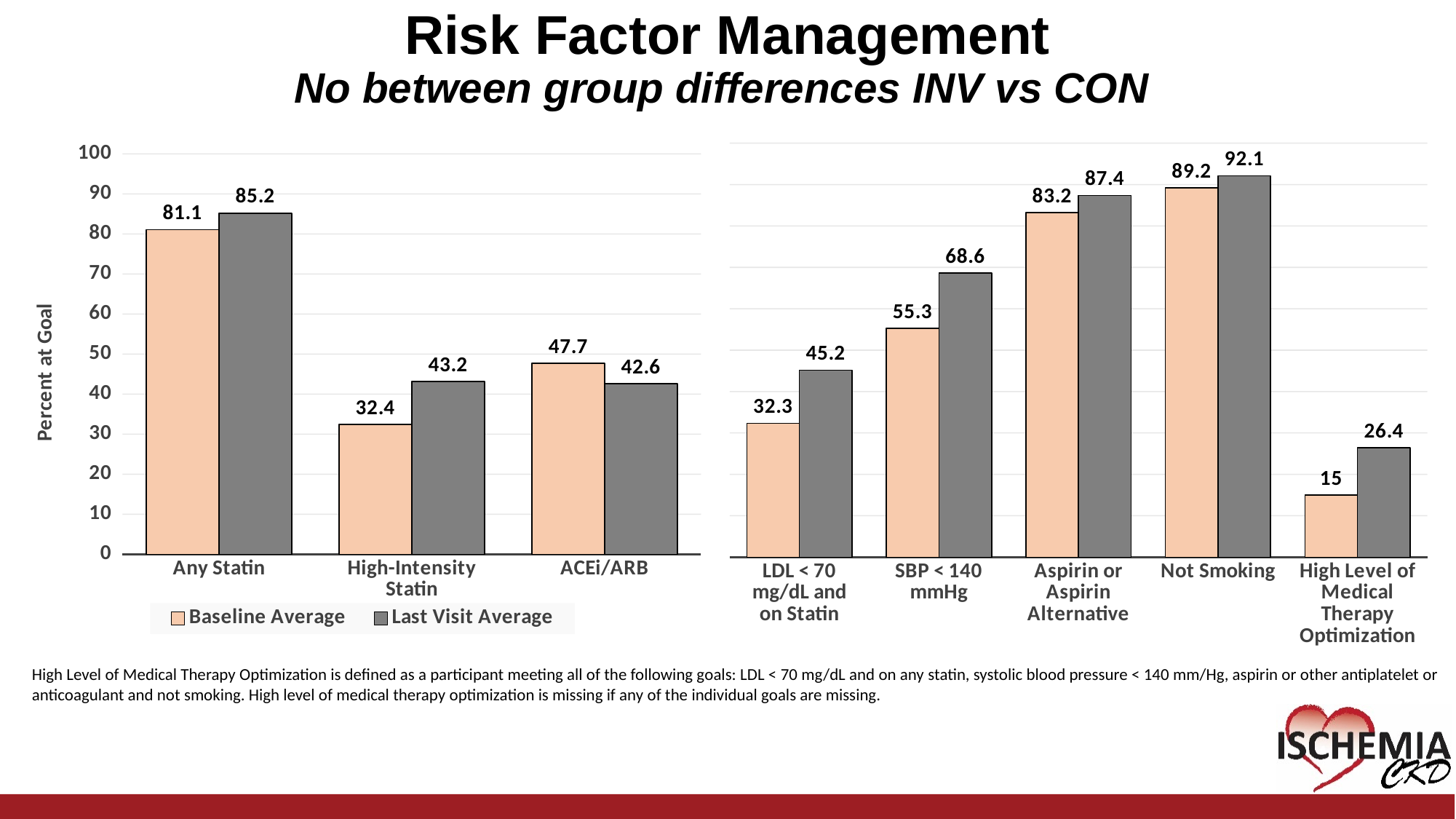
In the right chart, which category has the highest Last Visit Average value? Not Smoking How many categories are shown in the right chart? 5 What is the y-axis label of the left chart? Percent at Goal In the left chart, what is the Baseline Average value for Any Statin? 81.1 In the left chart, for ACEi/ARB, which is larger: the Baseline Average or the Last Visit Average? Baseline Average What kind of chart is the left chart? Bar chart In the right chart, what is the difference between the Last Visit Average and Baseline Average for LDL < 70 mg/dL and on Statin? 12.9 In the right chart, what is the Last Visit Average value for SBP < 140 mmHg? 68.6 In the right chart, what is the Baseline Average value for High Level of Medical Therapy Optimization? 15 How many series does the legend list? 2 In the left chart, what is the difference between the Last Visit Average and Baseline Average for High-Intensity Statin? 10.8 In the left chart, which category has the lowest Baseline Average value? High-Intensity Statin